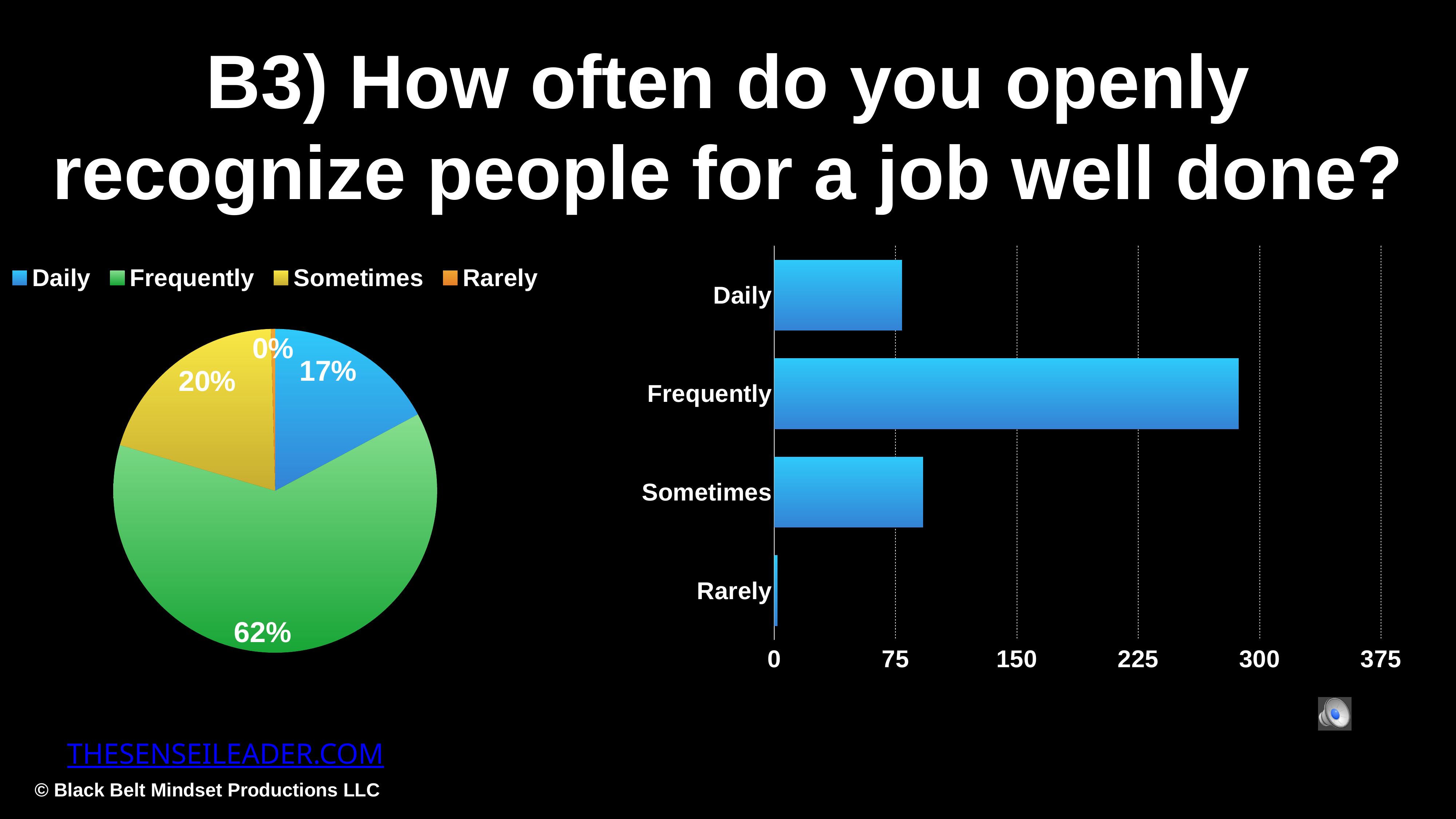
In the bar chart on the right, which category has the longest bar? Frequently In the pie chart on the left, what is the difference in percentage points between Frequently and Sometimes? 42 How many categories does the legend of the pie chart on the left list? 4 In the pie chart on the left, what percentage is shown for Sometimes? 20% In the bar chart on the right, is the value for Sometimes greater or less than 150? less In the pie chart on the left, what percentage is shown for Daily? 17% In the bar chart on the right, is the value for Frequently greater or less than 300? less In the pie chart on the left, which is larger, the share for Sometimes or the share for Daily? Sometimes In the pie chart on the left, which category has the largest share? Frequently In the pie chart on the left, what percentage is shown for Rarely? 0% What kind of chart is on the right side of the slide? Bar chart In the pie chart on the left, what percentage is shown for Frequently? 62%